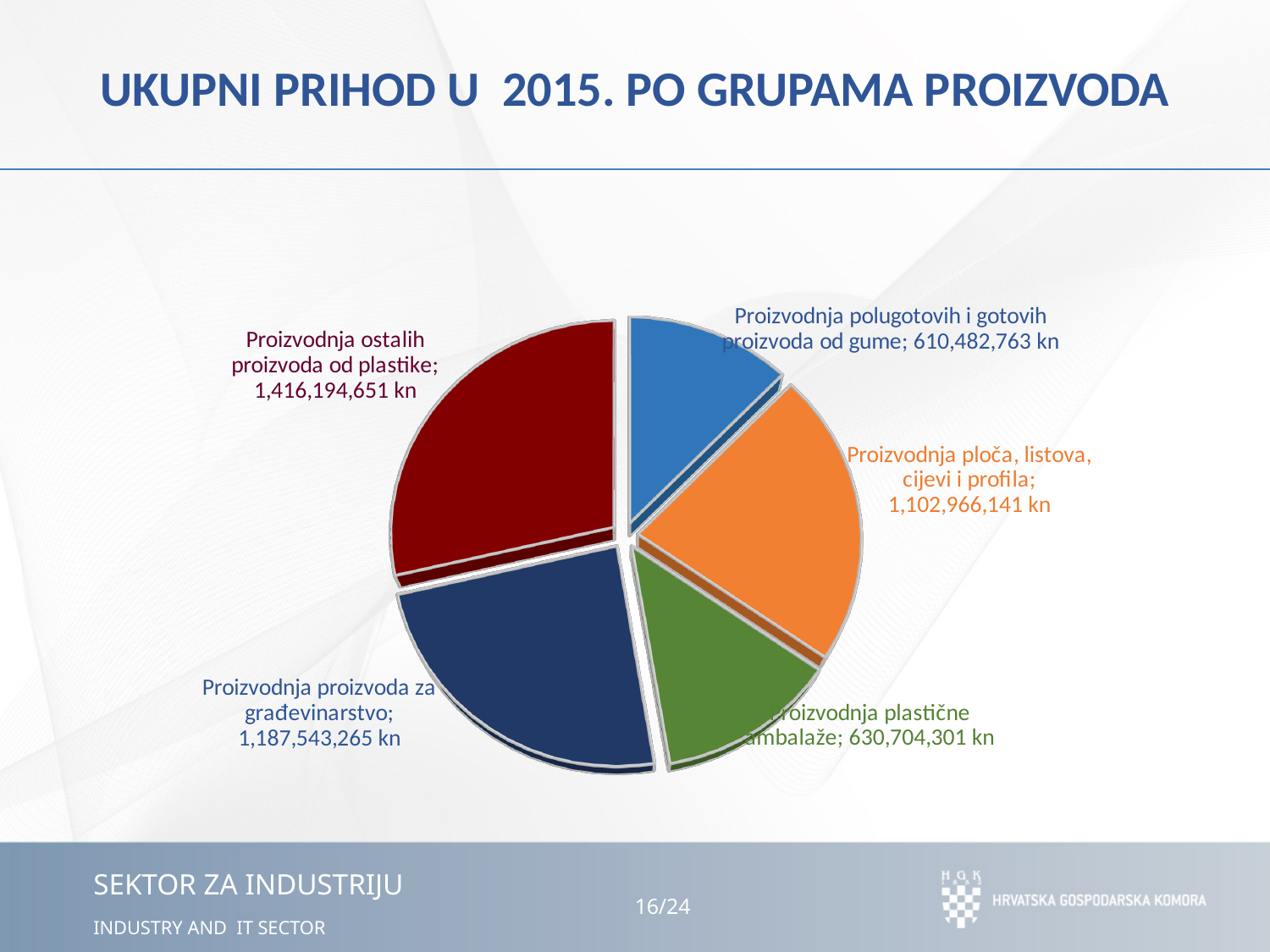
What type of chart is shown on the slide? Pie chart How many product groups (slices) does the pie chart show? 5 What is the chart's title? UKUPNI PRIHOD U 2015. PO GRUPAMA PROIZVODA What is the value for Proizvodnja ostalih proizvoda od plastike? 1,416,194,651 kn What is the value for Proizvodnja plastične ambalaže? 630,704,301 kn Which is larger: Proizvodnja plastične ambalaže or Proizvodnja polugotovih i gotovih proizvoda od gume? Proizvodnja plastične ambalaže Which product group has the highest revenue? Proizvodnja ostalih proizvoda od plastike What is the value for Proizvodnja ploča, listova, cijevi i profila? 1,102,966,141 kn What is the total revenue across all five product groups? 4,947,891,121 kn What is the difference between Proizvodnja ostalih proizvoda od plastike and Proizvodnja proizvoda za građevinarstvo? 228,651,386 kn What is the value for Proizvodnja polugotovih i gotovih proizvoda od gume? 610,482,763 kn Which product group has the lowest revenue? Proizvodnja polugotovih i gotovih proizvoda od gume